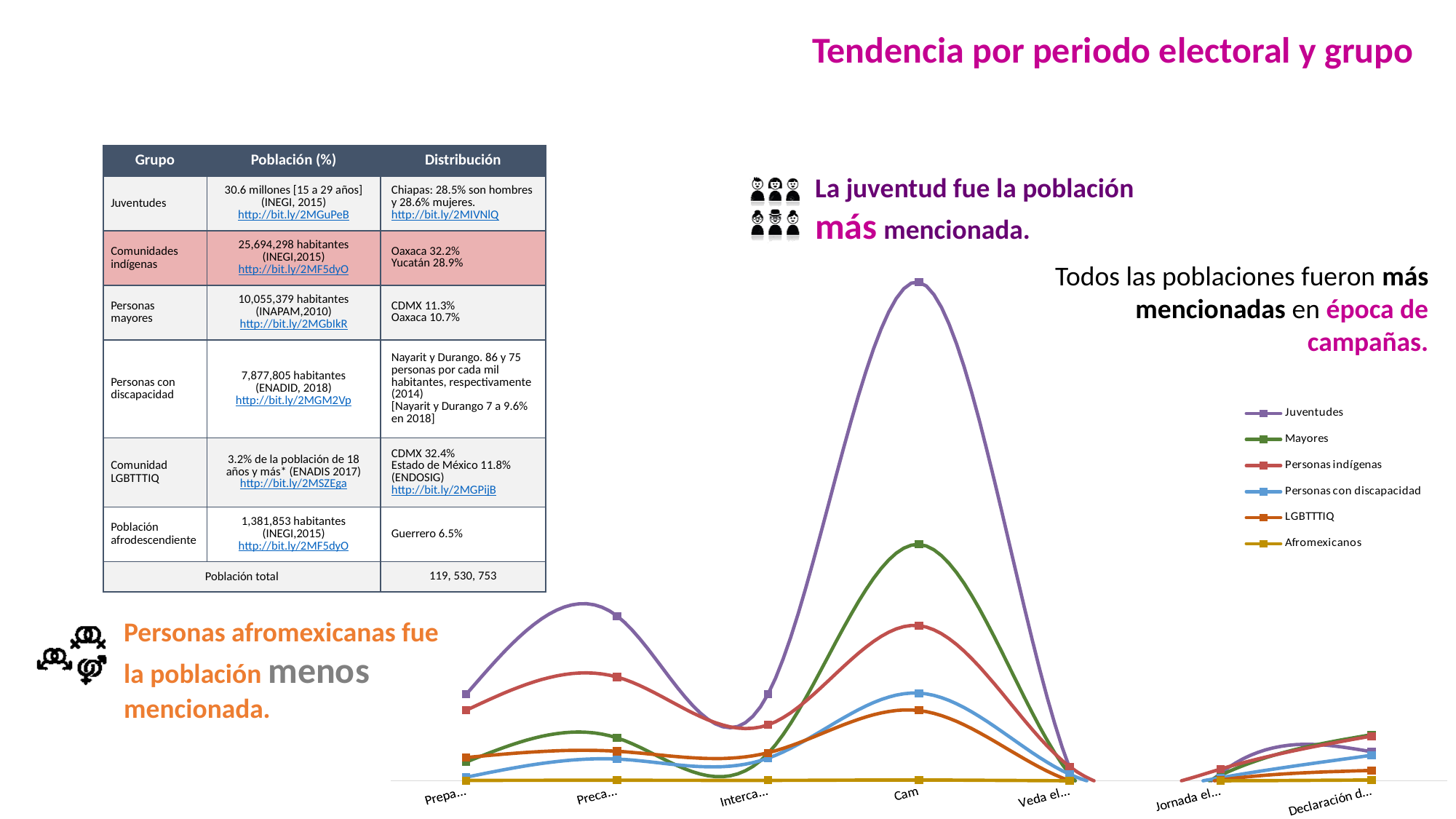
Which series has the lowest values across the chart? Afromexicanos Does the Juventudes series rise or fall from "Interca..." to "Cam"? rise Which series reaches the highest value at the "Cam" category? Juventudes How many series does the chart legend list? 6 Does the Juventudes series rise or fall from "Cam" to "Veda el..."? fall What kind of chart is shown on the slide? line chart How many categories are shown along the x axis of the chart? 7 At the "Preca..." category, which series is higher: Personas indígenas or Mayores? Personas indígenas At the "Cam" category, which series is higher: Juventudes or Mayores? Juventudes At the "Cam" category, which series is higher: Personas indígenas or Personas con discapacidad? Personas indígenas Which series is drawn in purple in the chart? Juventudes